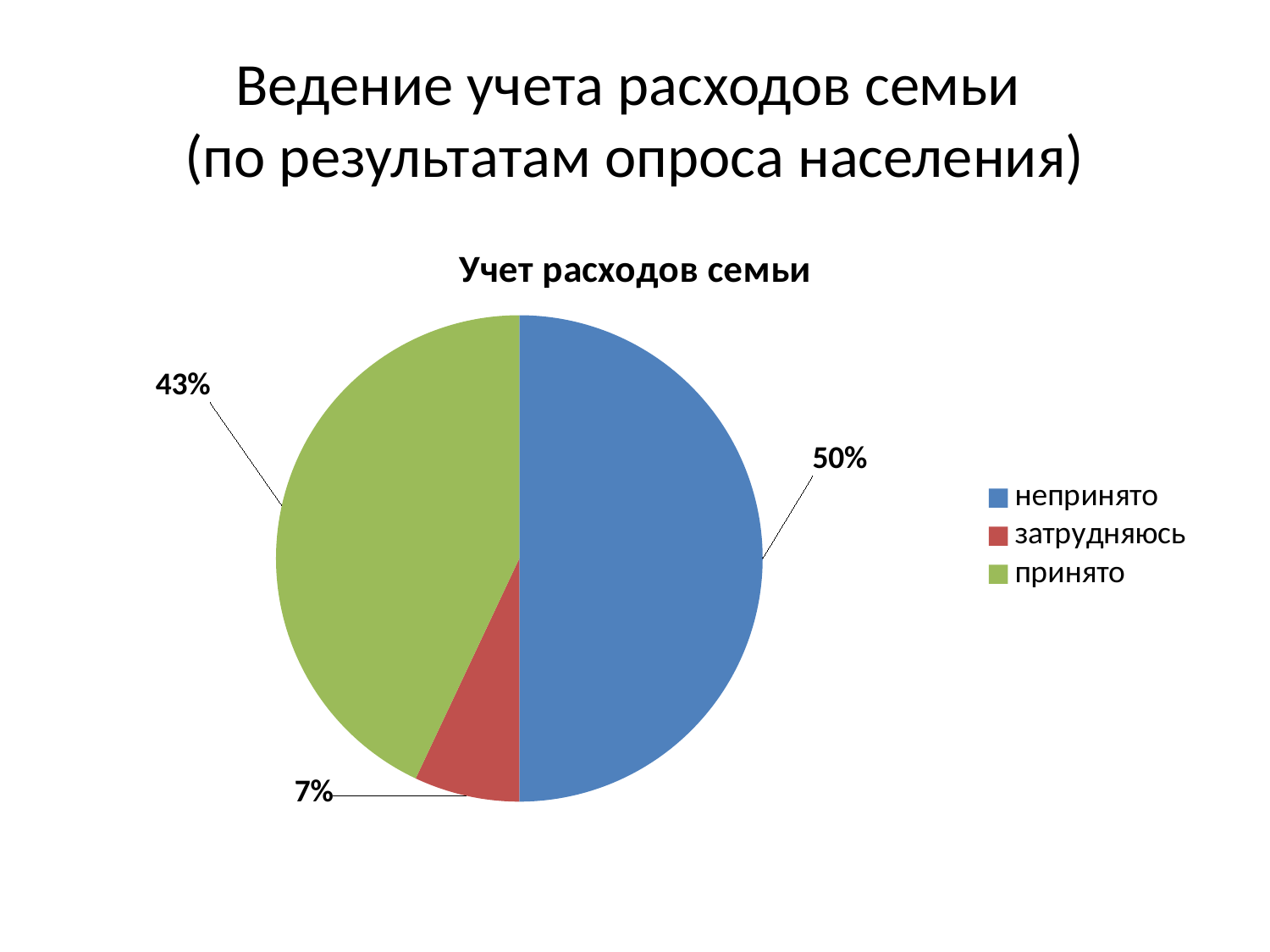
What is the difference in percentage points between the "принято" and "затрудняюсь" slices? 36% What share of the pie does the "принято" slice represent? 43% How many categories are shown in the pie chart? 3 Which category has the smallest slice of the pie? затрудняюсь What share of the pie does the "непринято" slice represent? 50% What kind of chart is shown on the slide? pie chart What is the difference in percentage points between the "непринято" and "принято" slices? 7% Which slice is larger, "принято" or "затрудняюсь"? принято Which category has the largest slice of the pie? непринято Which colour represents the "затрудняюсь" category in the legend? red What is the title of the chart? Учет расходов семьи What share of the pie does the "затрудняюсь" slice represent? 7%